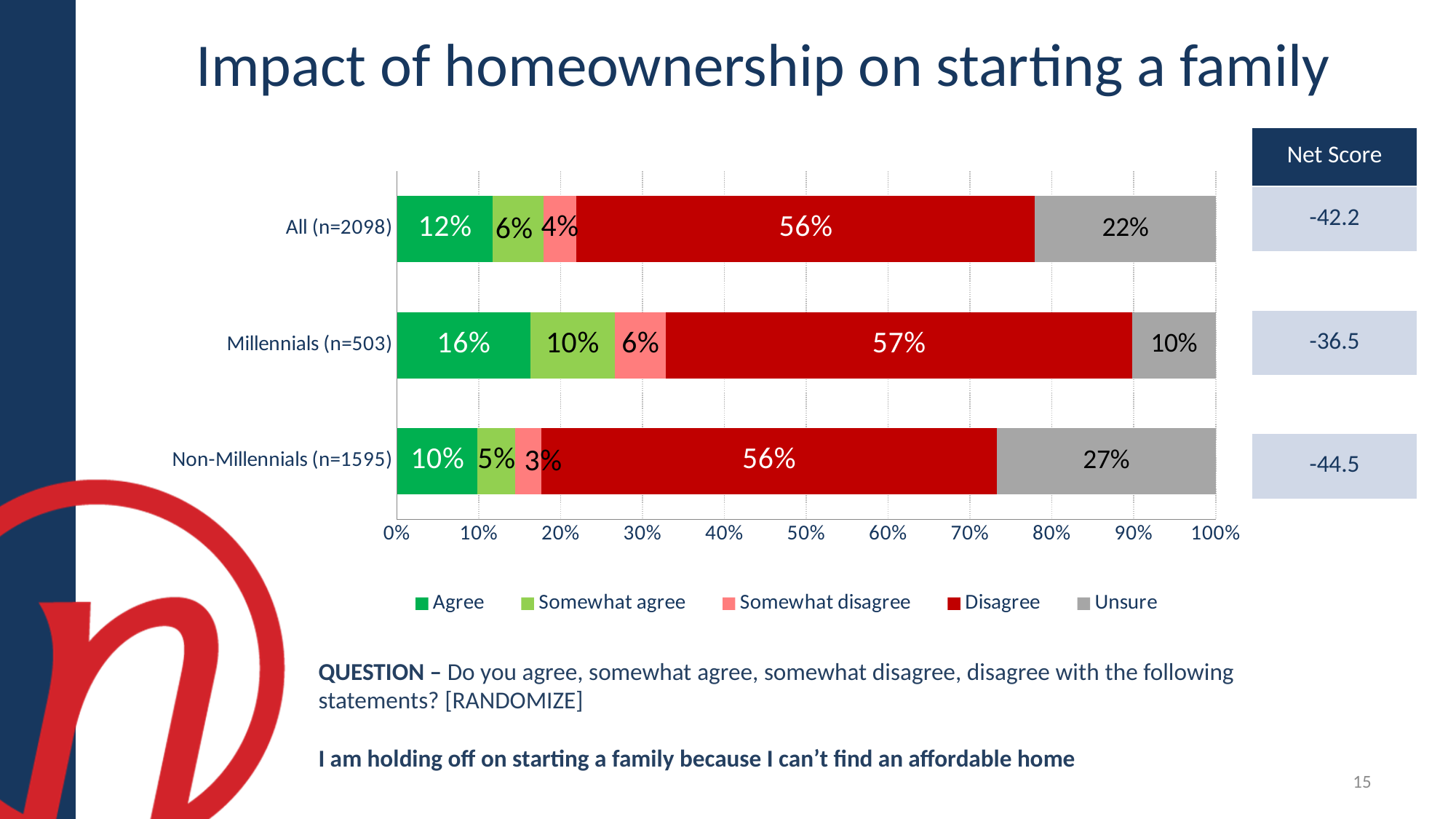
How many series does the legend list? 5 How many groups (bars) are shown in the chart? 3 What percentage of Millennials (n=503) answered Agree? 16% Which group has the highest Unsure percentage? Non-Millennials (n=1595) Which group has the lowest Agree percentage? Non-Millennials (n=1595) What is the Net Score shown for Millennials (n=503)? -36.5 What kind of chart is shown on the slide? Stacked bar chart What percentage of All (n=2098) answered Disagree? 56% What percentage of Non-Millennials (n=1595) answered Unsure? 27% What is the Somewhat disagree value for Non-Millennials (n=1595)? 3% Which is larger: the Unsure value for All (n=2098) or for Millennials (n=503)? All (n=2098) What is the difference between the Somewhat agree values for Millennials (n=503) and Non-Millennials (n=1595)? 5%